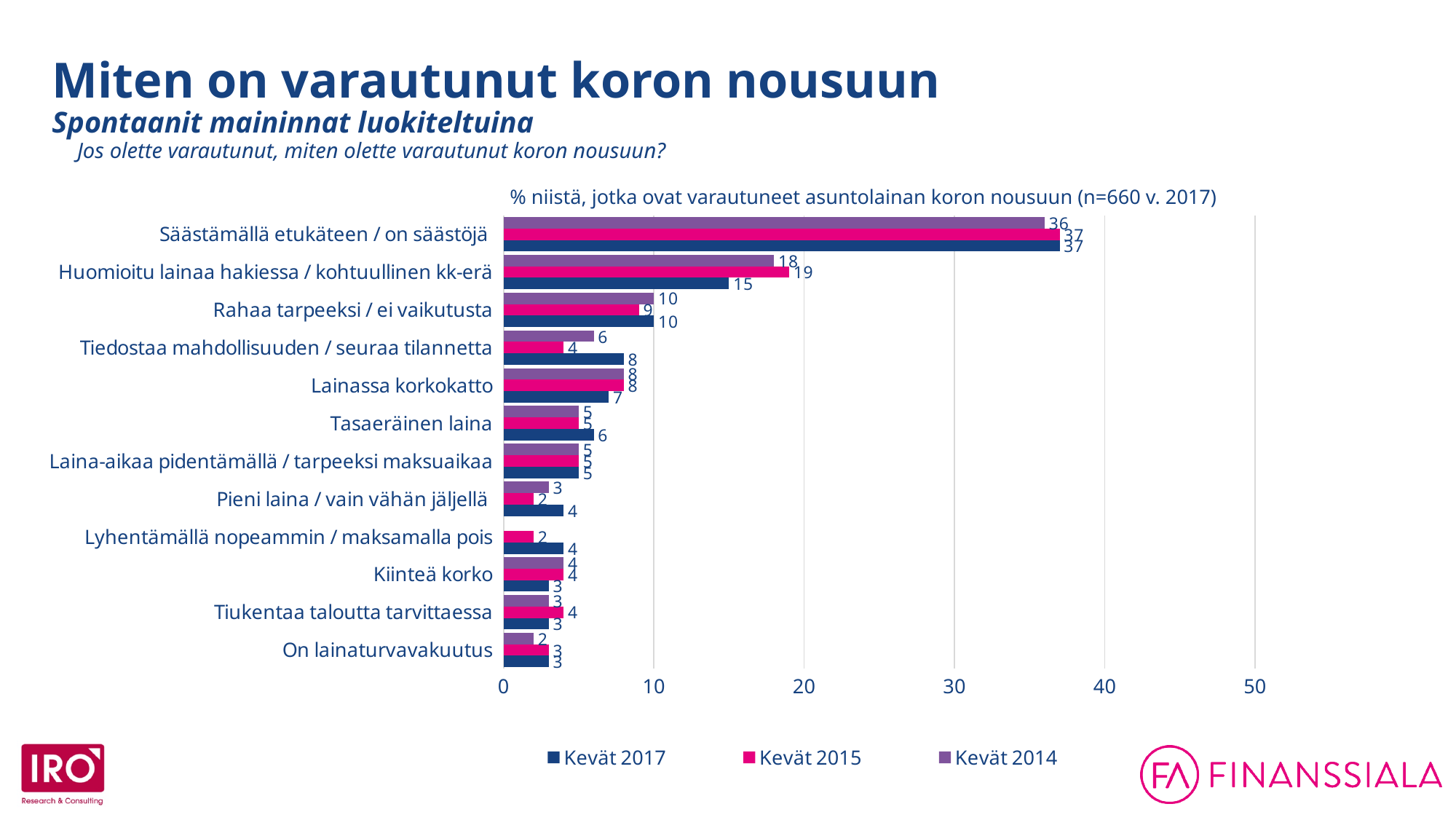
What is the Kevät 2015 value for 'Pieni laina / vain vähän jäljellä'? 2 What is the Kevät 2017 value for 'Huomioitu lainaa hakiessa / kohtuullinen kk-erä'? 15 What is the Kevät 2015 value for 'Säästämällä etukäteen / on säästöjä'? 37 What kind of chart is shown on the slide? bar chart How many categories are shown on the chart? 12 What is the Kevät 2014 value for 'Tiedostaa mahdollisuuden / seuraa tilannetta'? 6 Is the Kevät 2014 value for 'Säästämällä etukäteen / on säästöjä' greater or less than 30? greater How many series does the legend list? 3 For 'Tiedostaa mahdollisuuden / seuraa tilannetta', which is larger: the Kevät 2017 value or the Kevät 2015 value? Kevät 2017 Which category has the highest Kevät 2017 value? Säästämällä etukäteen / on säästöjä What is the difference between the Kevät 2015 and Kevät 2017 values for 'Huomioitu lainaa hakiessa / kohtuullinen kk-erä'? 4 Which series is shown in pink in the legend? Kevät 2015